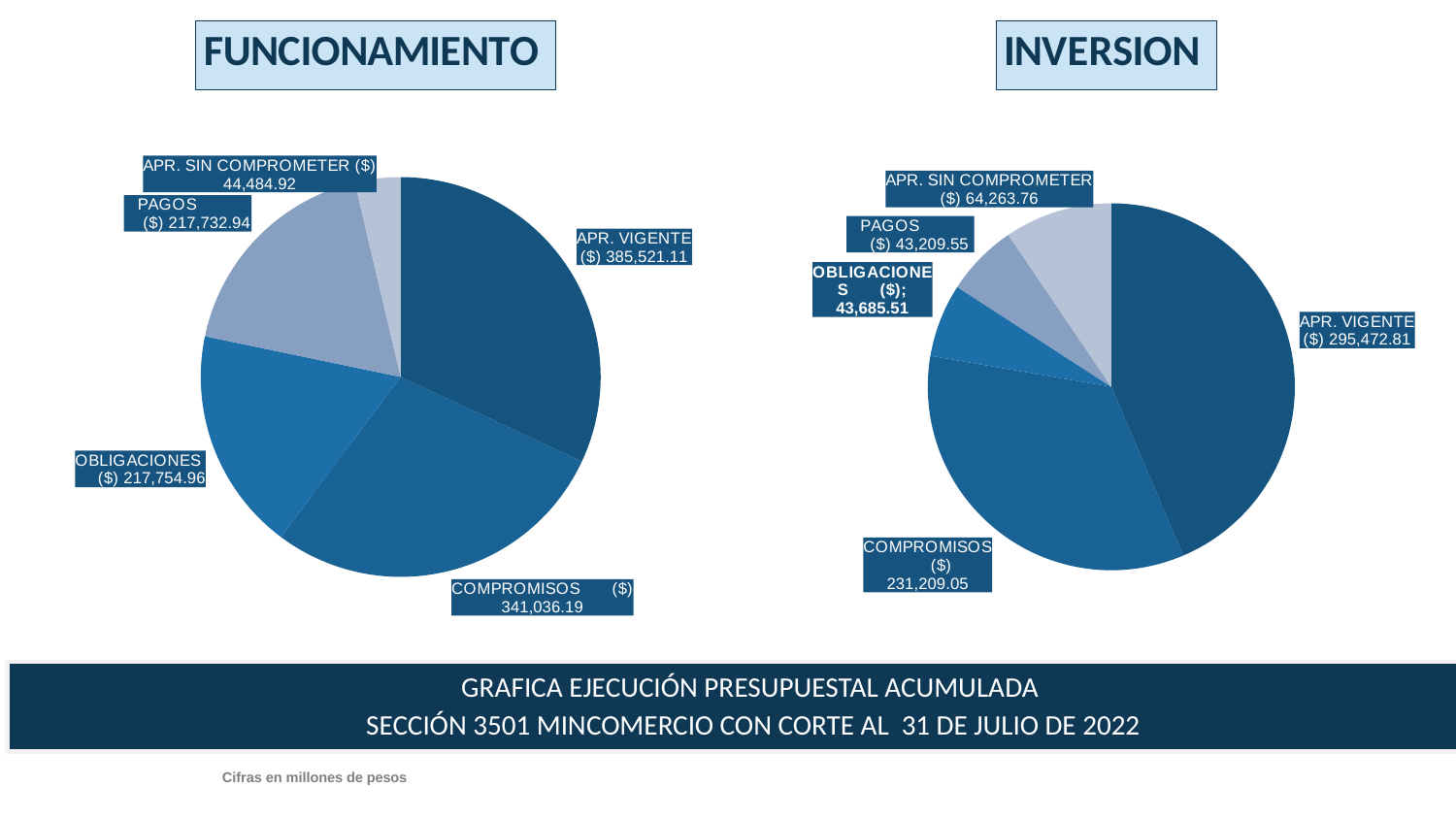
In the INVERSION chart, which category has the largest slice? APR. VIGENTE How many slices does the FUNCIONAMIENTO pie chart have? 5 In the INVERSION chart, what is the value for PAGOS? ($) 43,209.55 In the FUNCIONAMIENTO chart, what is the value for APR. SIN COMPROMETER? ($) 44,484.92 In the FUNCIONAMIENTO chart, which category has the smallest slice? APR. SIN COMPROMETER In the INVERSION chart, which is larger: COMPROMISOS or APR. SIN COMPROMETER? COMPROMISOS In the FUNCIONAMIENTO chart, what is the value for APR. VIGENTE? ($) 385,521.11 In the INVERSION chart, what is the difference between APR. VIGENTE and COMPROMISOS? 64,263.76 In the INVERSION chart, what is the value for APR. VIGENTE? ($) 295,472.81 In the FUNCIONAMIENTO chart, what is the value for COMPROMISOS? ($) 341,036.19 What type of chart is used for FUNCIONAMIENTO? Pie chart In the FUNCIONAMIENTO chart, what is the difference between APR. VIGENTE and COMPROMISOS? 44,484.92